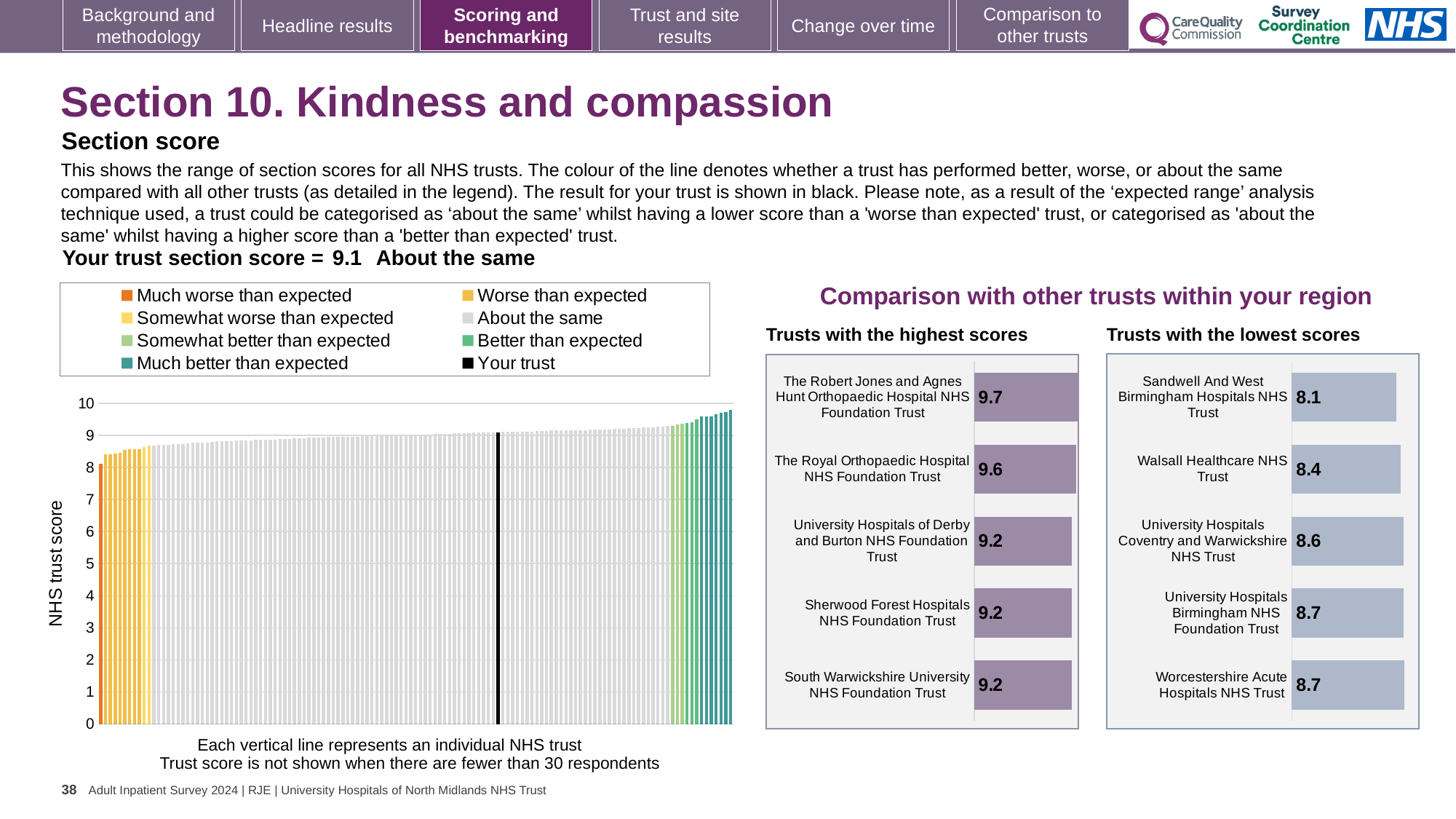
In the 'Trusts with the lowest scores' chart, what is the score for Walsall Healthcare NHS Trust? 8.4 In the 'Trusts with the lowest scores' chart, what is the difference between the scores of Walsall Healthcare NHS Trust and Sandwell And West Birmingham Hospitals NHS Trust? 0.3 How many entries does the legend of the main NHS trust score chart list? 8 In the 'Trusts with the highest scores' chart, which trust has the highest score? The Robert Jones and Agnes Hunt Orthopaedic Hospital NHS Foundation Trust In the 'Trusts with the highest scores' chart, what is the score for The Robert Jones and Agnes Hunt Orthopaedic Hospital NHS Foundation Trust? 9.7 What kind of chart is the main chart showing NHS trust scores on the left of the slide? Bar chart In the 'Trusts with the highest scores' chart, what is the difference between the scores of The Robert Jones and Agnes Hunt Orthopaedic Hospital NHS Foundation Trust and The Royal Orthopaedic Hospital NHS Foundation Trust? 0.1 In the main NHS trust score chart on the left, do the bar values rise or fall from left to right? Rise In the 'Trusts with the lowest scores' chart, which trust has the lowest score? Sandwell And West Birmingham Hospitals NHS Trust In the main NHS trust score chart on the left, what colour represents 'Your trust' in the legend? Black In the 'Trusts with the lowest scores' chart, which has the larger score: Walsall Healthcare NHS Trust or University Hospitals Coventry and Warwickshire NHS Trust? University Hospitals Coventry and Warwickshire NHS Trust How many trusts are listed in the 'Trusts with the highest scores' chart? 5